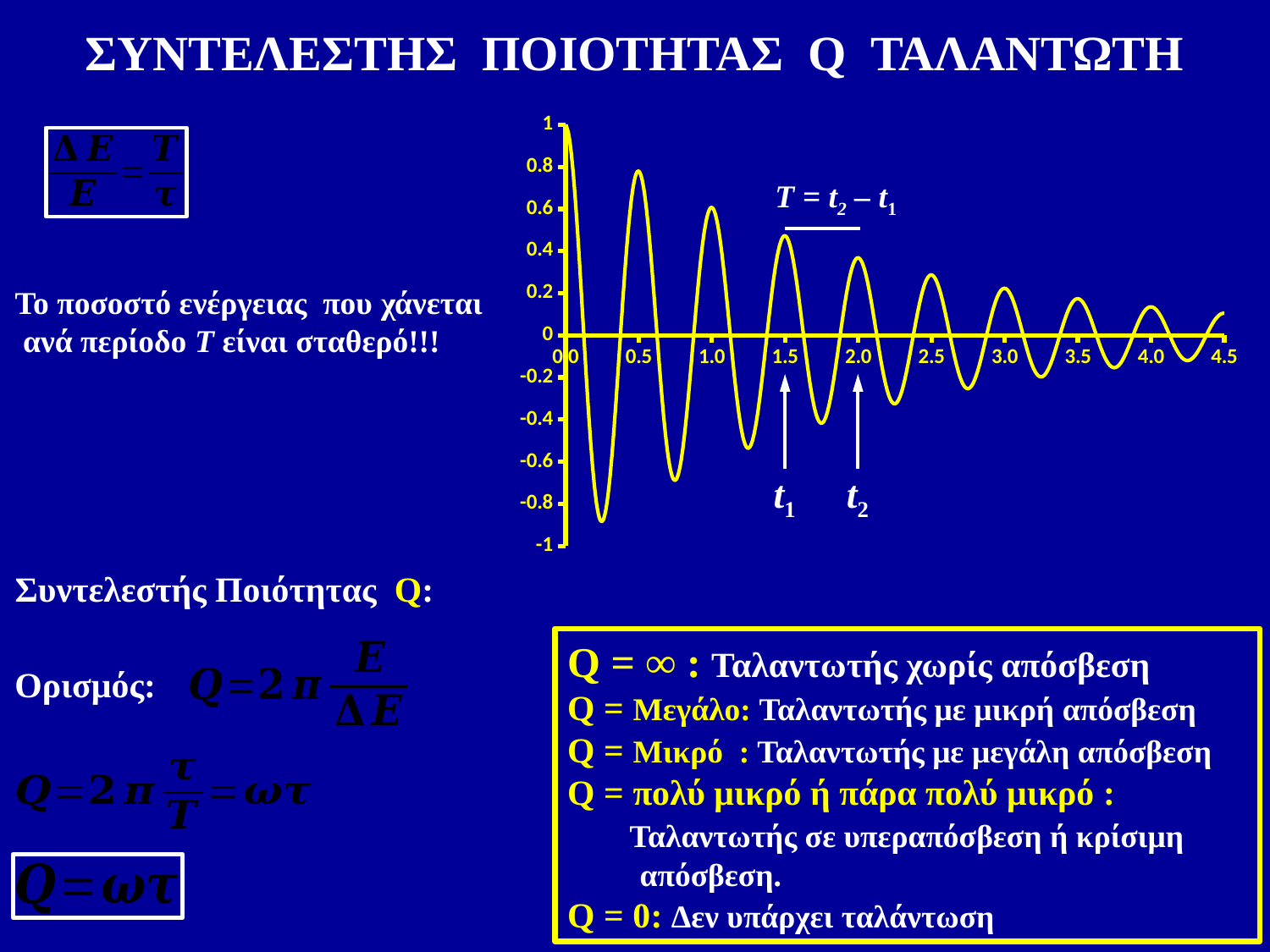
What formula is annotated above the curve between the two arrows? T = t2 − t1 How many tick labels are shown on the x axis? 10 Is the peak near x = 2.0 greater or less than 0.6? less Is the first peak after x = 0 (near x = 0.5) greater or less than 0.6? greater Is the first trough (near x = 0.25) greater or less than -0.8? less Which peak is larger: the one near x = 0.5 or the one near x = 1.0? the one near x = 0.5 What is the highest tick value shown on the y axis? 1 What is the value of the curve at x = 0.0? 1 What kind of chart is shown on the slide? line chart At which x value does the curve reach its highest value? 0.0 Do the peaks of the plotted curve rise or fall as x increases? fall